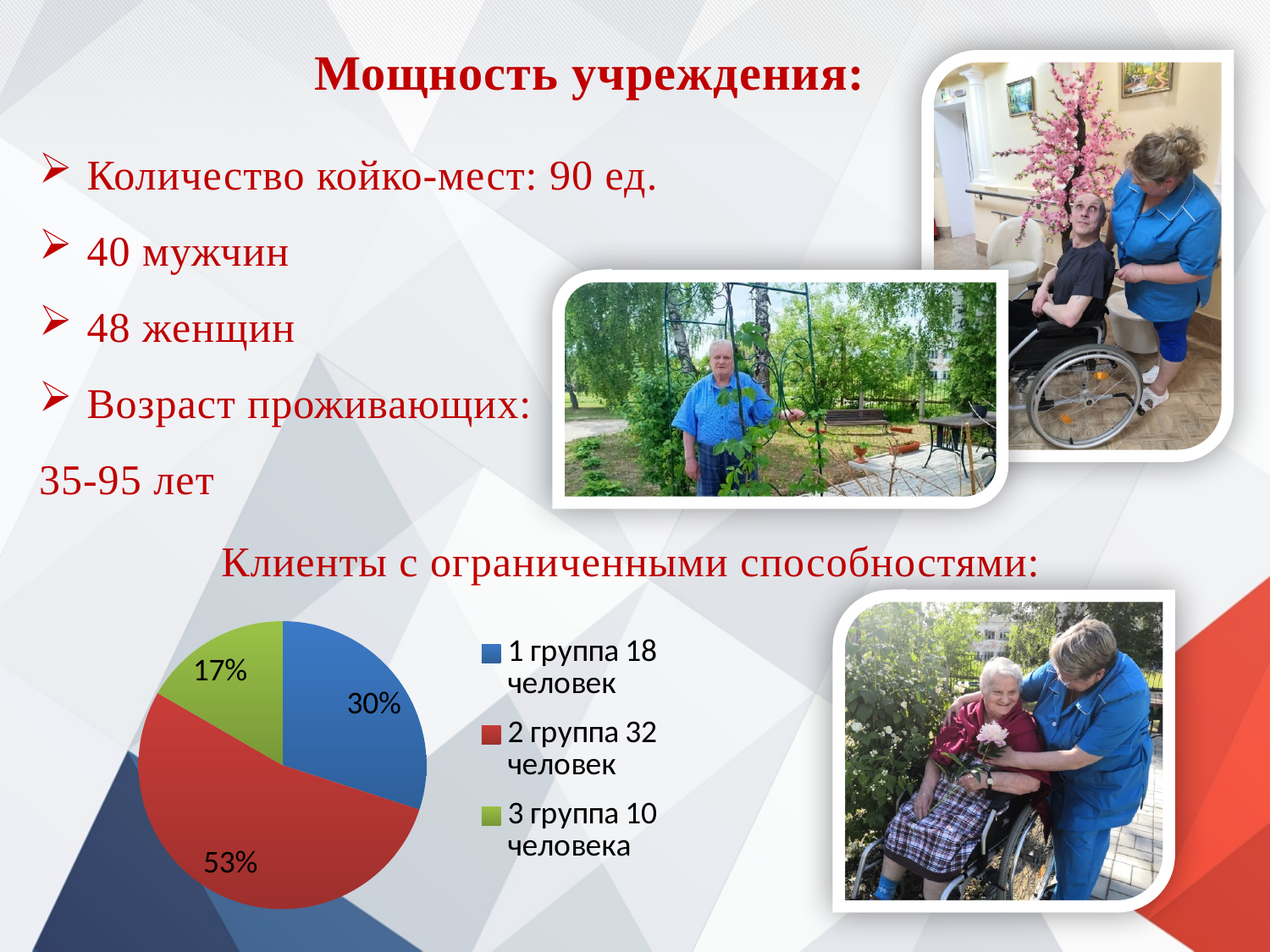
What share of the pie does "1 группа 18 человек" take? 30% What share of the pie does "3 группа 10 человека" take? 17% What share of the pie does "2 группа 32 человек" take? 53% Which slice is larger: "1 группа 18 человек" or "3 группа 10 человека"? 1 группа 18 человек What colour is the slice for "2 группа 32 человек" in the pie chart? red How many slices does the pie chart have? 3 Which group has the smallest slice of the pie chart? 3 группа 10 человека How many entries does the legend of the pie chart list? 3 What kind of chart is shown on the slide? pie chart What is the difference in percentage points between the "2 группа" slice and the "1 группа" slice? 23 Which group has the largest slice of the pie chart? 2 группа 32 человек What is the heading shown above the pie chart? Клиенты с ограниченными способностями: